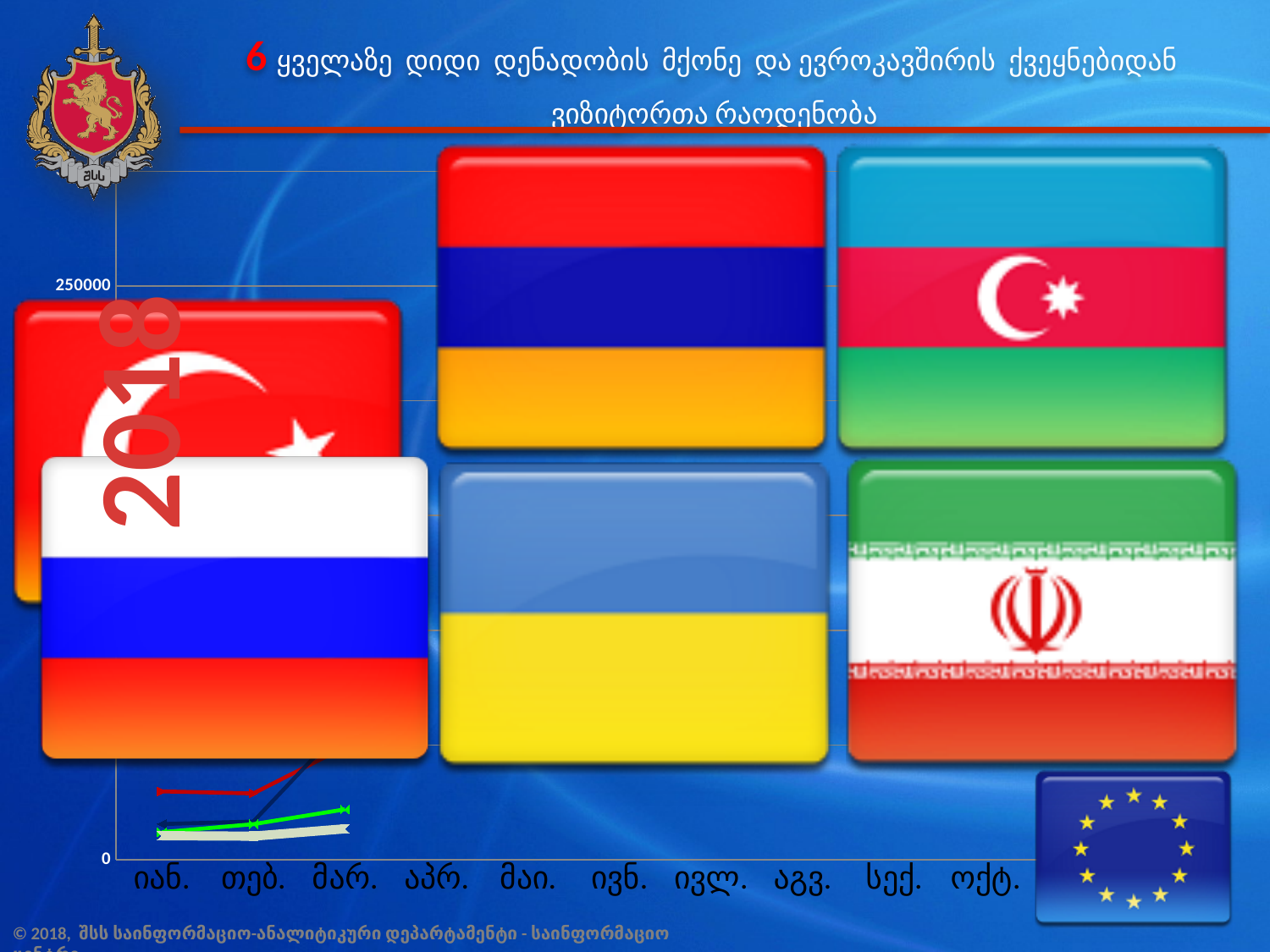
How many month categories are labelled along the x axis of the chart? 10 What is the highest value labelled on the y axis of the chart? 250000 What is the lowest value labelled on the y axis of the chart? 0 What kind of chart is shown on the slide? line chart What is the last category label on the x axis of the chart? ოქტ. What is the first category label on the x axis of the chart? იან.